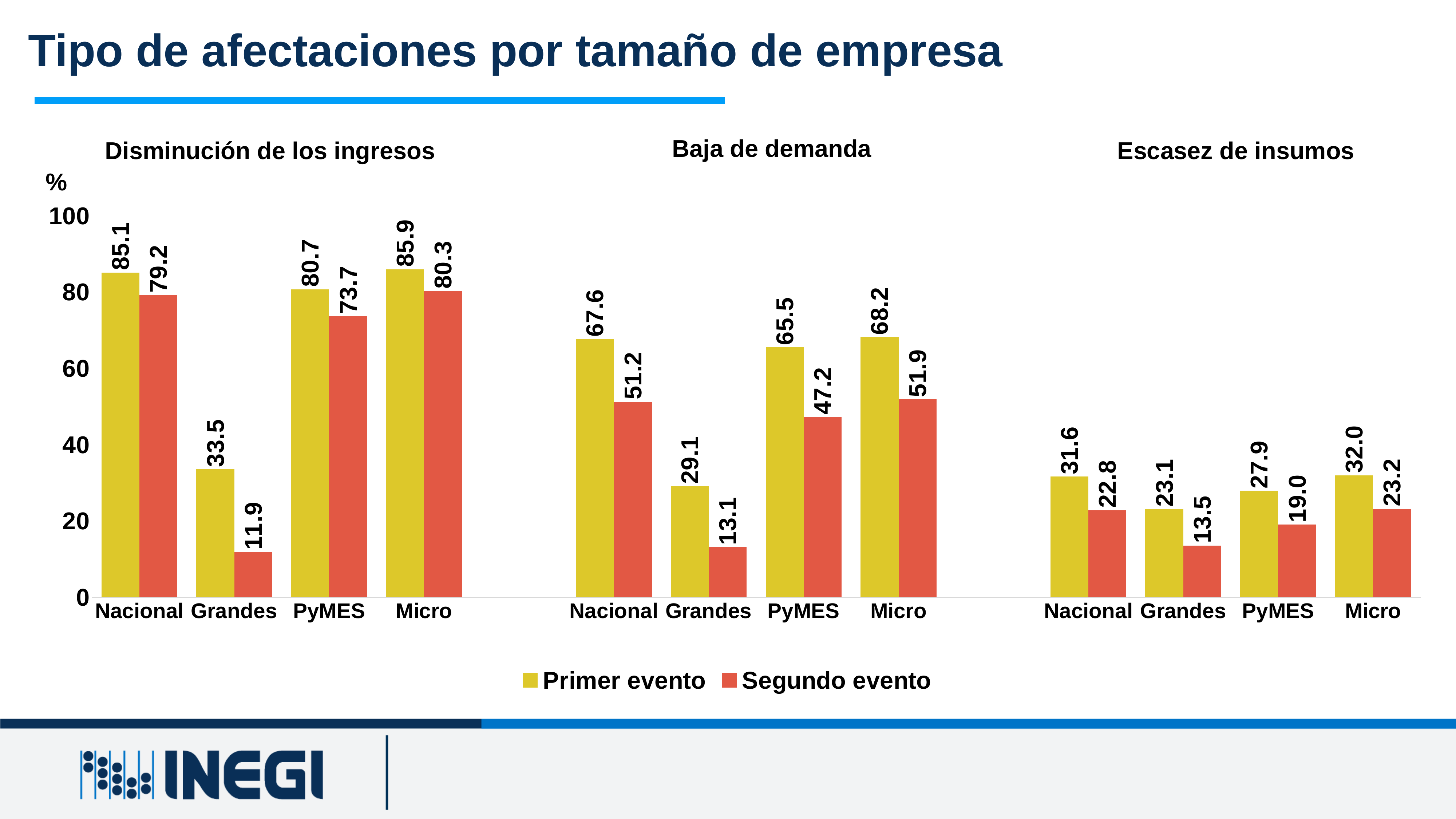
In the 'Disminución de los ingresos' chart, which category has the lowest Segundo evento value? Grandes In the 'Disminución de los ingresos' chart, what is the difference between the Primer evento values for Micro and PyMES? 5.2 In the 'Escasez de insumos' chart, what is the value for Micro in the Primer evento series? 32.0 In the 'Escasez de insumos' chart, is the Primer evento value for Nacional greater or less than 40? less In the 'Disminución de los ingresos' chart, what is the value for Nacional in the Primer evento series? 85.1 In the 'Baja de demanda' chart, which is larger: the Segundo evento value for Nacional or for Micro? Micro What kind of chart is the 'Escasez de insumos' chart? bar chart In the 'Baja de demanda' chart, which category has the highest Primer evento value? Micro In the 'Baja de demanda' chart, what is the value for PyMES in the Segundo evento series? 47.2 How many series does the legend list? 2 In the 'Escasez de insumos' chart, what is the difference between the Primer evento and Segundo evento values for Grandes? 9.6 How many categories are shown on the x axis of the 'Baja de demanda' chart? 4